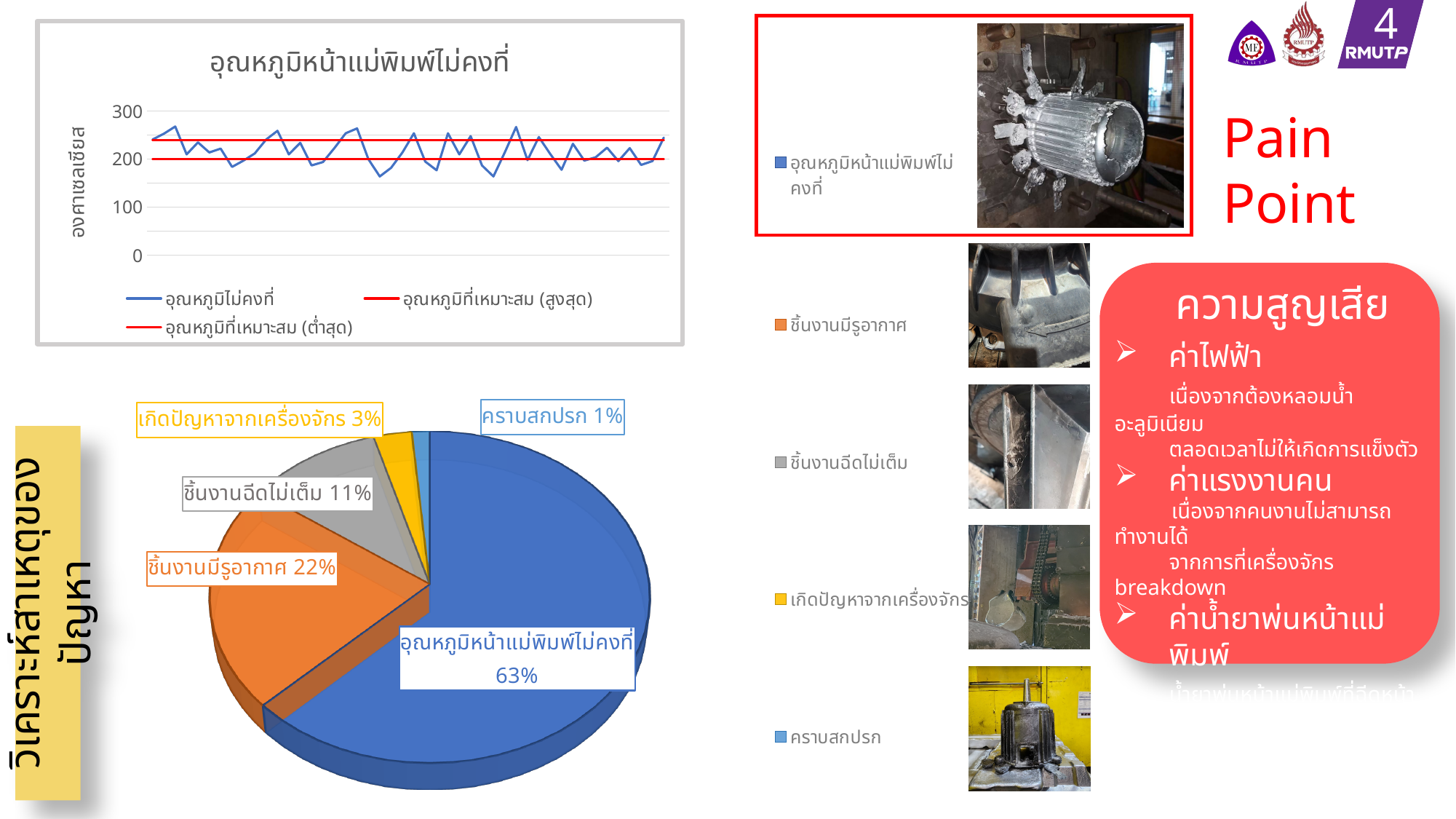
In the line chart titled อุณหภูมิหน้าแม่พิมพ์ไม่คงที่, what is the y-axis label? องศาเซลเซียส What kind of chart is the bottom-left chart on the slide? pie chart In the pie chart, what is the value for ชิ้นงานฉีดไม่เต็ม? 11% In the pie chart, which category has the largest slice? อุณหภูมิหน้าแม่พิมพ์ไม่คงที่ What kind of chart is the top-left chart titled อุณหภูมิหน้าแม่พิมพ์ไม่คงที่? line chart In the pie chart, which is larger: เกิดปัญหาจากเครื่องจักร or คราบสกปรก? เกิดปัญหาจากเครื่องจักร In the pie chart, which category has the smallest slice? คราบสกปรก In the pie chart, what is the value for ชิ้นงานมีรูอากาศ? 22% In the pie chart, what share does อุณหภูมิหน้าแม่พิมพ์ไม่คงที่ have? 63% How many slices does the pie chart have? 5 In the pie chart, what is the difference between ชิ้นงานมีรูอากาศ and ชิ้นงานฉีดไม่เต็ม? 11% How many series does the legend of the line chart titled อุณหภูมิหน้าแม่พิมพ์ไม่คงที่ list? 3